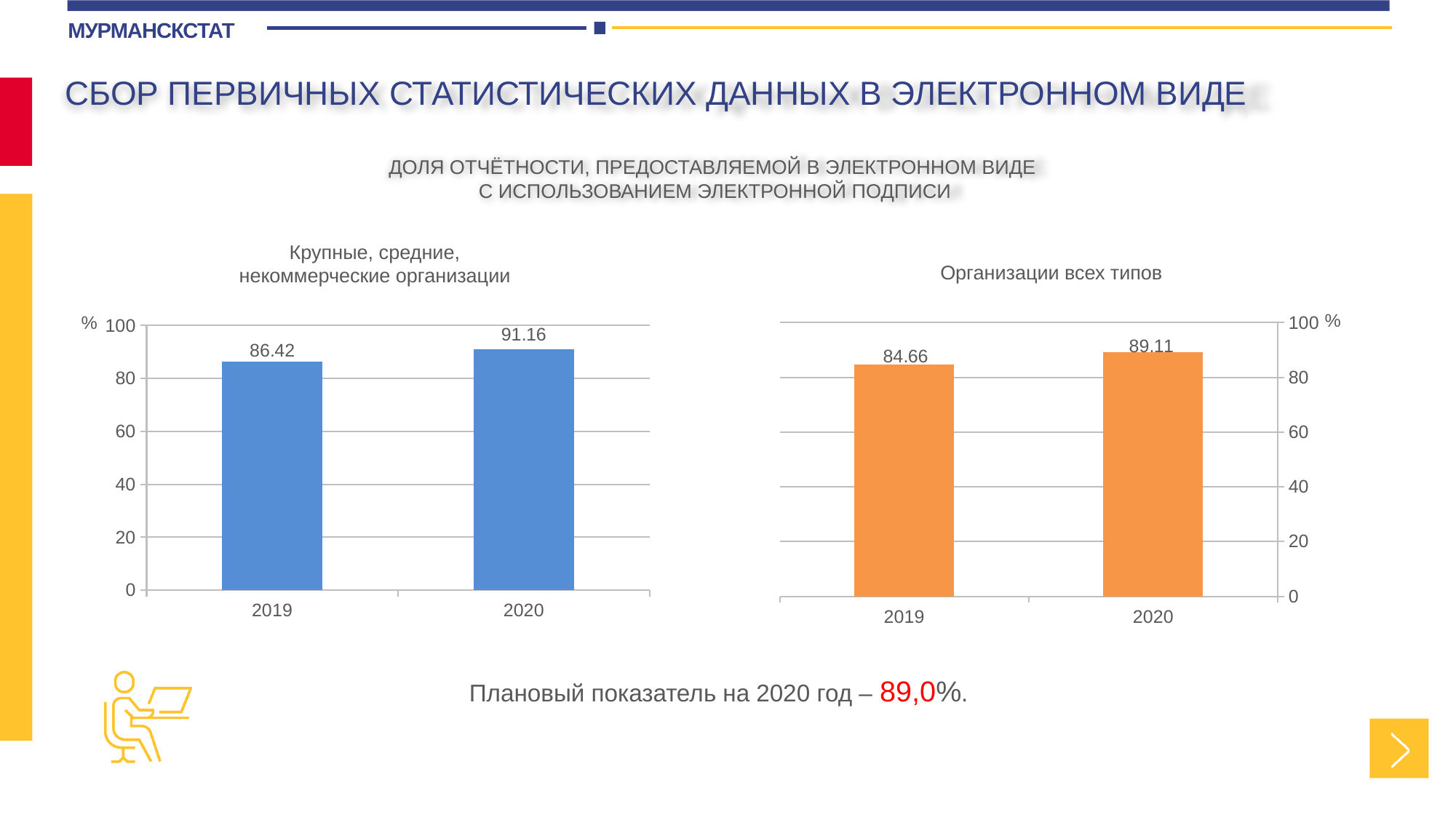
In the chart titled "Крупные, средние, некоммерческие организации", what is the difference between the 2020 and 2019 values? 4.74 In the chart titled "Организации всех типов", what is the value for 2019? 84.66 In the chart titled "Организации всех типов", what is the difference between the 2020 and 2019 values? 4.45 In the chart titled "Организации всех типов", do the values rise or fall from 2019 to 2020? Rise In the chart titled "Организации всех типов", which year has the lower value? 2019 In the chart titled "Крупные, средние, некоммерческие организации", which year has the higher value? 2020 In the chart titled "Организации всех типов", what is the value for 2020? 89.11 Is the 2019 value in the chart titled "Организации всех типов" greater or less than 80? greater In the chart titled "Крупные, средние, некоммерческие организации", what is the value for 2020? 91.16 In the chart titled "Крупные, средние, некоммерческие организации", what is the value for 2019? 86.42 How many years are shown on the x axis of the chart titled "Крупные, средние, некоммерческие организации"? 2 What type of chart is the chart titled "Организации всех типов"? Bar chart